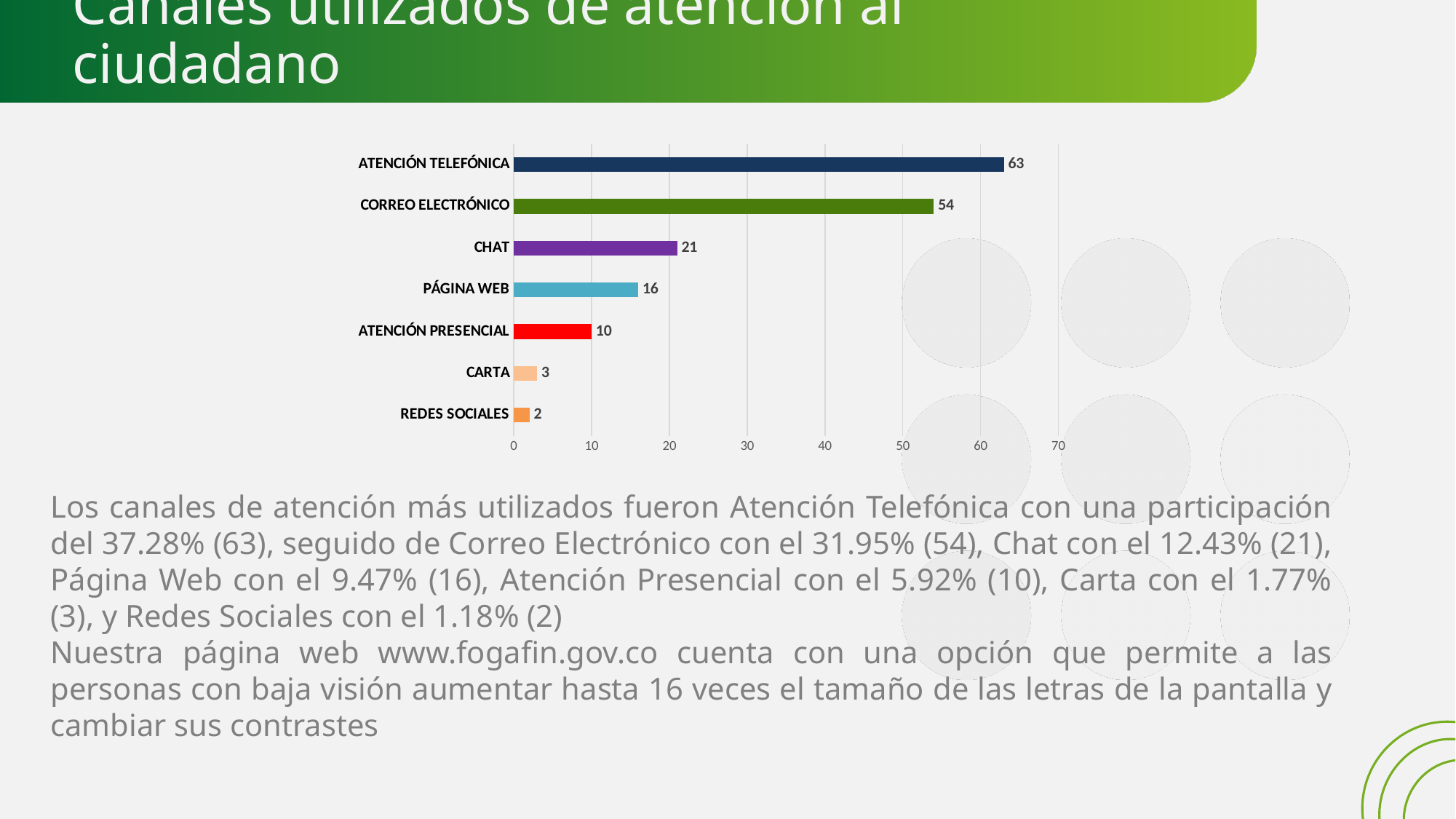
Which category has the highest value? ATENCIÓN TELEFÓNICA What is the difference between the values for ATENCIÓN TELEFÓNICA and CORREO ELECTRÓNICO? 9 What is the value for CORREO ELECTRÓNICO? 54 What is the value for PÁGINA WEB? 16 What is the difference between the values for CHAT and PÁGINA WEB? 5 What kind of chart is shown on the slide? bar chart What is the value for CARTA? 3 Which is larger, the value for ATENCIÓN PRESENCIAL or the value for PÁGINA WEB? PÁGINA WEB What colour is the bar for ATENCIÓN PRESENCIAL? red Which category has the lowest value? REDES SOCIALES What is the value for ATENCIÓN TELEFÓNICA? 63 How many categories are shown in the chart? 7